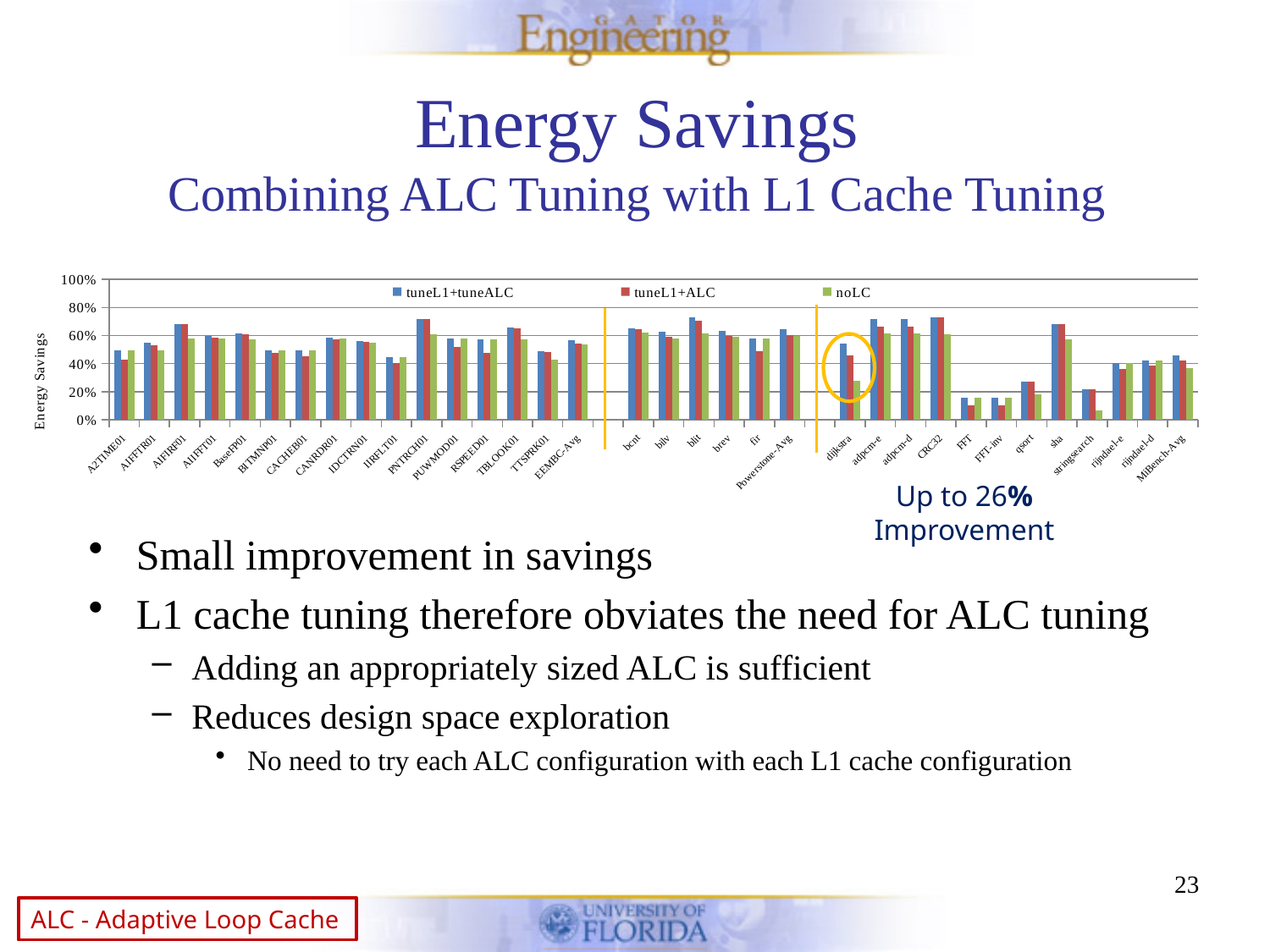
What are the three series named in the chart legend? tuneL1+tuneALC, tuneL1+ALC, noLC What kind of chart is shown on the slide? bar chart Which has the larger tuneL1+ALC value, sha or stringsearch? sha Is the noLC value for stringsearch greater or less than 20%? less How many series does the chart legend list? 3 Is the tuneL1+tuneALC value for dijkstra greater or less than 40%? greater Which has the larger tuneL1+tuneALC value, CRC32 or FFT? CRC32 Is the tuneL1+ALC value for CRC32 greater or less than 60%? greater What is the label on the vertical axis of the chart? Energy Savings How many benchmark categories are plotted along the x axis of the chart? 34